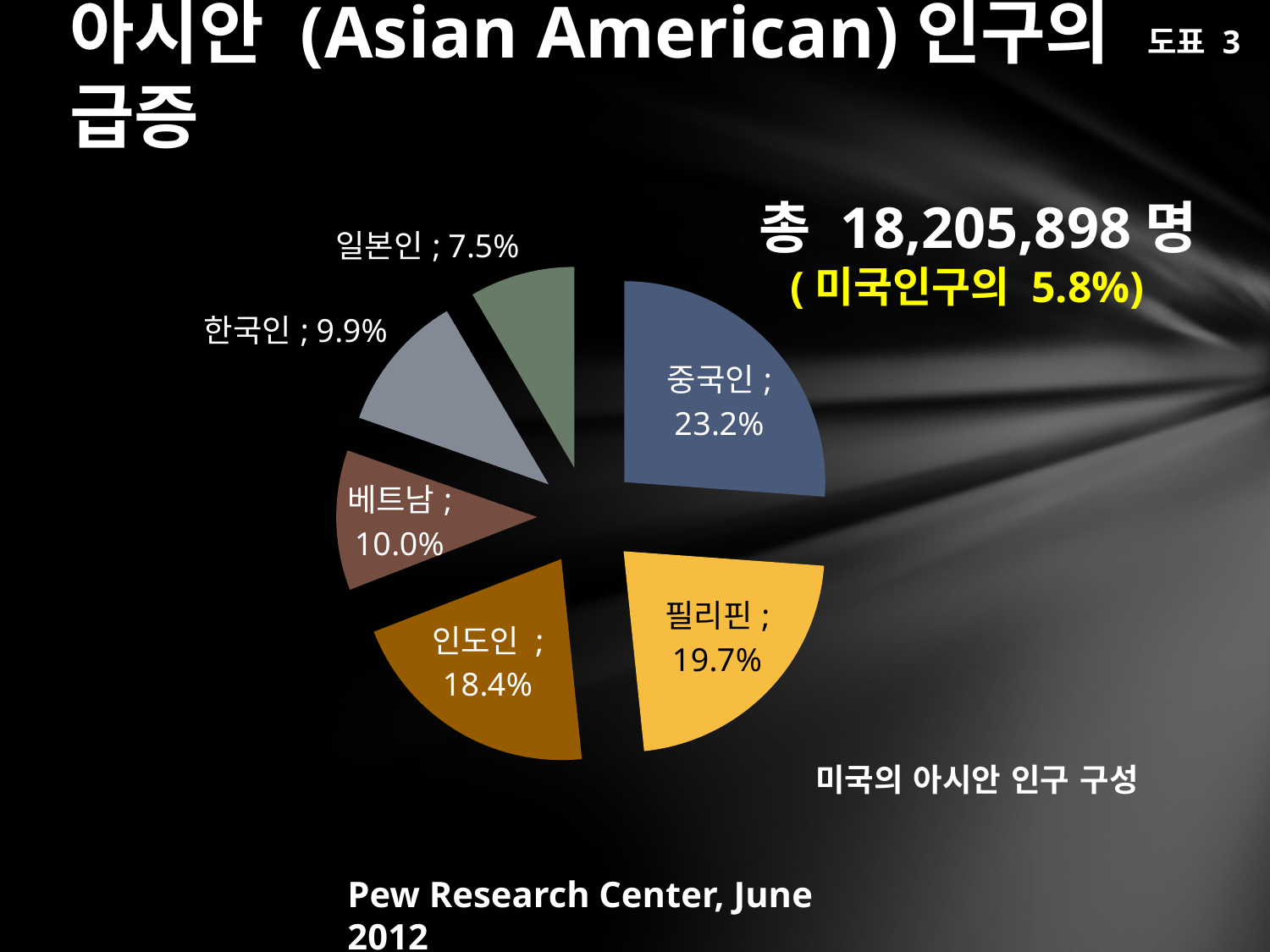
What percentage is shown for 필리핀 in the pie chart? 19.7% Which slice is larger, 인도인 or 베트남? 인도인 What share of the pie does 한국인 represent? 9.9% What percentage is shown for 중국인 in the pie chart? 23.2% How many slices does the pie chart have? 6 What total population figure is printed next to the pie chart? 18,205,898 명 What percentage is shown for 인도인 in the pie chart? 18.4% Which group has the smallest slice of the pie chart? 일본인 Which group has the largest slice of the pie chart? 중국인 What percentage is shown for 일본인 in the pie chart? 7.5% What type of chart is shown on the slide? pie chart What is the difference in percentage points between 중국인 and 필리핀? 3.5